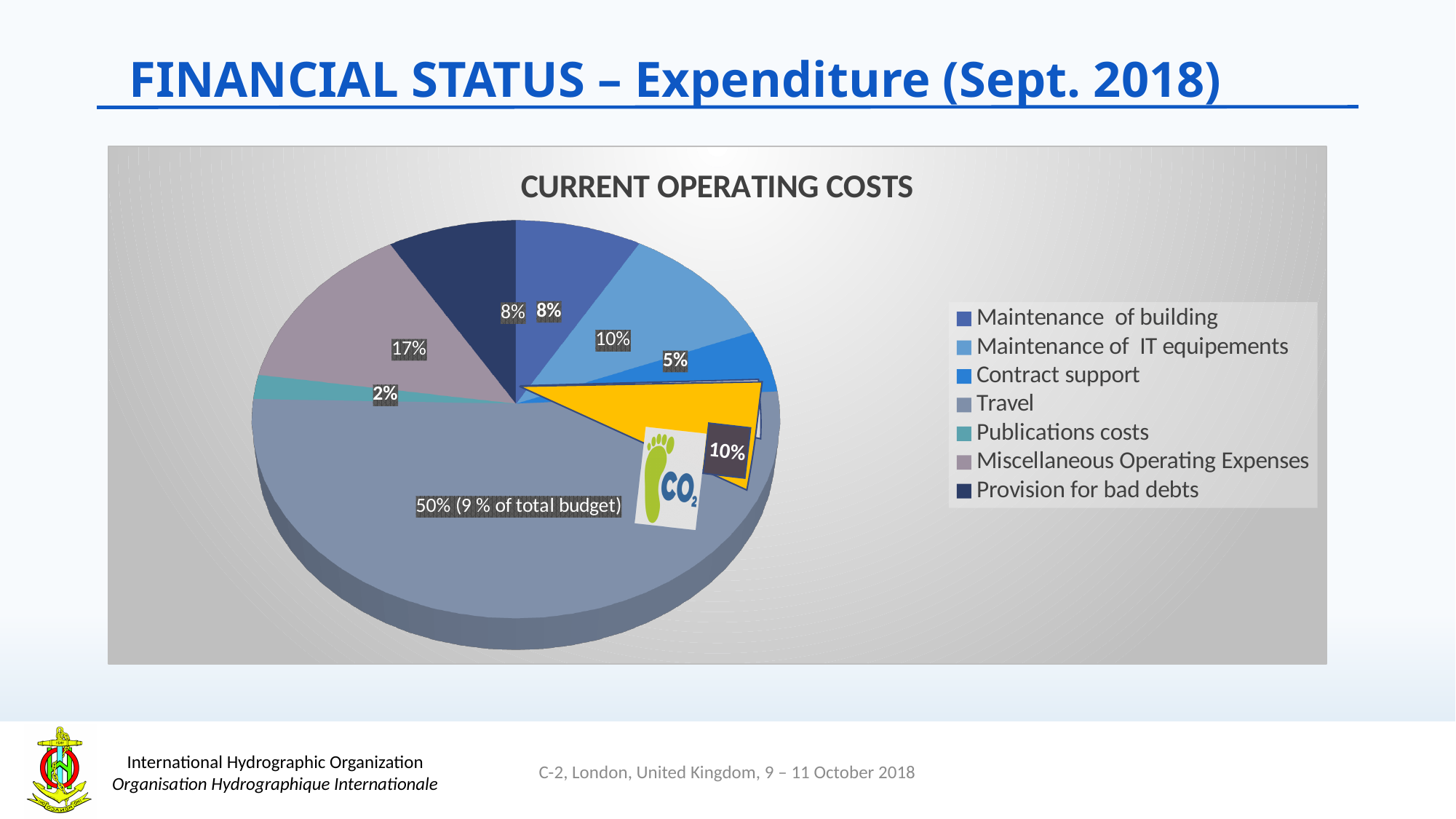
What share of current operating costs is Maintenance of IT equipements? 10% What is the title of the pie chart? CURRENT OPERATING COSTS How many entries does the legend list? 7 What share of current operating costs is Miscellaneous Operating Expenses? 17% What share of current operating costs is Contract support? 5% What kind of chart is shown on the slide? Pie chart Which category has the largest share of the pie? Travel What share of current operating costs is Publications costs? 2% Which is larger, the share for Contract support or the share for Maintenance of building? Maintenance of building By how many percentage points does Miscellaneous Operating Expenses exceed Maintenance of IT equipements? 7 percentage points Which category has the smallest share of the pie? Publications costs What share of current operating costs is Travel? 50%